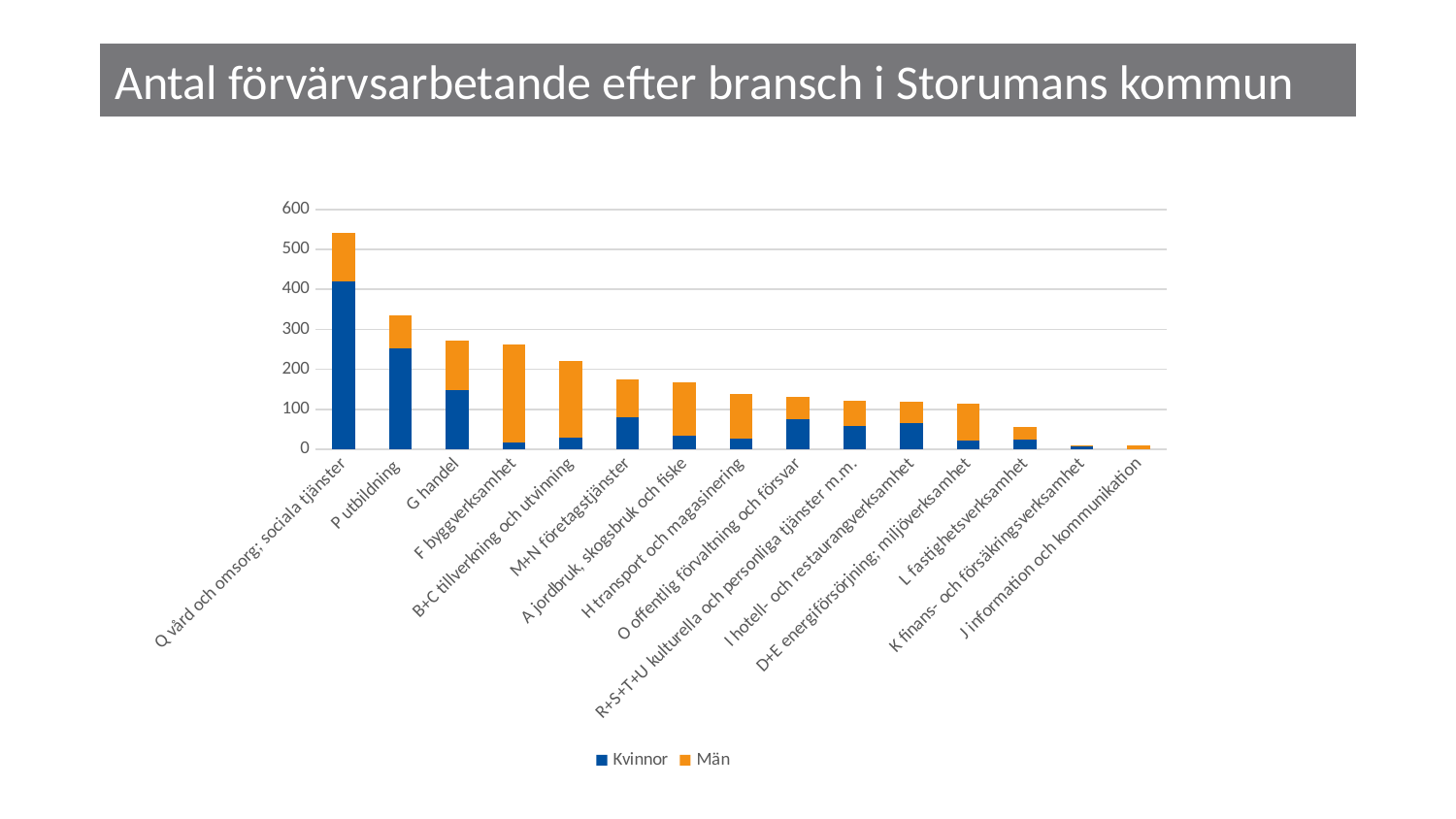
Which has more Män: F byggverksamhet or G handel? F byggverksamhet Which has more Kvinnor: Q vård och omsorg; sociala tjänster or P utbildning? Q vård och omsorg; sociala tjänster Do the total bar heights rise or fall from left to right along the x axis? fall What kind of chart is shown on the slide? Stacked bar chart Is the total value for P utbildning greater or less than 300? greater Which branch has the highest total number of employed people? Q vård och omsorg; sociala tjänster How many branches (categories) are shown on the x axis? 15 How many series does the legend list? 2 Is the total value for Q vård och omsorg; sociala tjänster greater or less than 500? greater Is the Kvinnor value for F byggverksamhet greater or less than 100? less What is the title of the chart? Antal förvärvsarbetande efter bransch i Storumans kommun Which series is shown in orange? Män